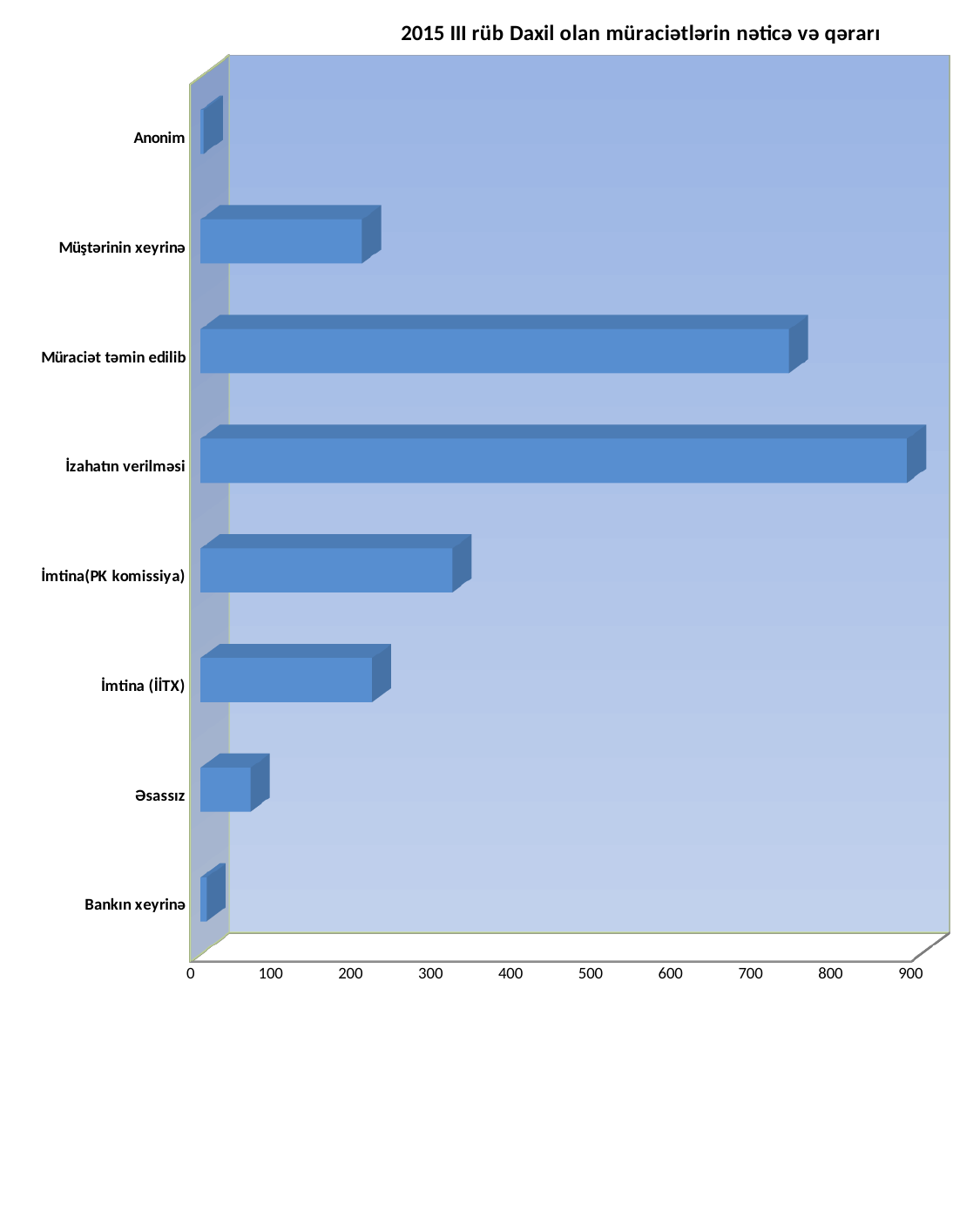
What is the title of the chart? 2015 III rüb Daxil olan müraciətlərin nəticə və qərarı Is the value for İzahatın verilməsi greater or less than 800? greater Which category has the highest value? İzahatın verilməsi Is the value for Müştərinin xeyrinə greater or less than 300? less What type of chart is shown on the slide? Bar chart Which is larger, the value for Müraciət təmin edilib or the value for İmtina(PK komissiya)? Müraciət təmin edilib Which is larger, the value for İmtina(PK komissiya) or the value for İmtina (İİTX)? İmtina(PK komissiya) How many categories are plotted in the chart? 8 Is the value for Müraciət təmin edilib greater or less than 700? greater